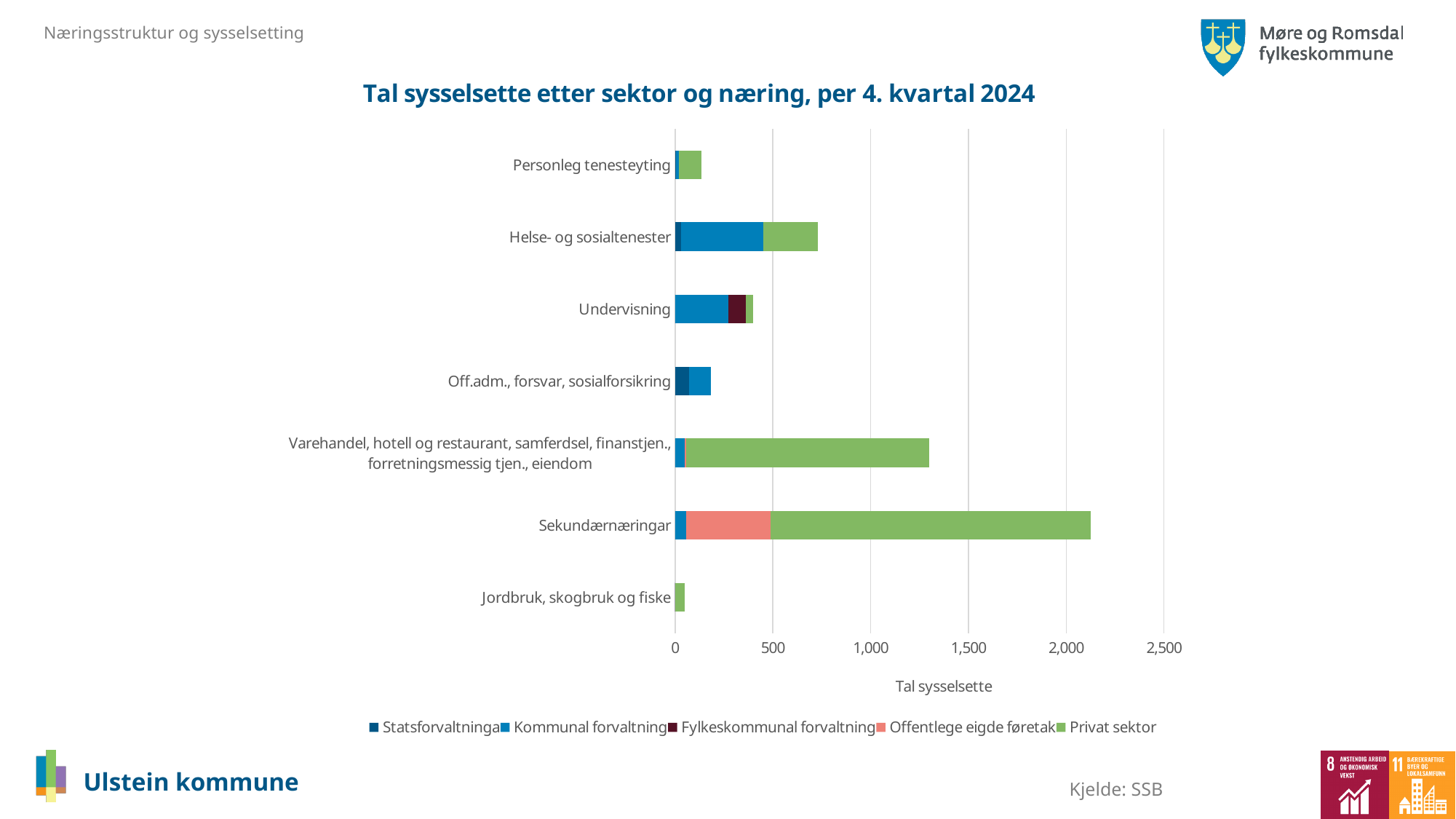
What is the title of the chart? Tal sysselsette etter sektor og næring, per 4. kvartal 2024 Which category has the shortest total bar? Jordbruk, skogbruk og fiske Which has the larger total bar: Helse- og sosialtenester or Undervisning? Helse- og sosialtenester Is the total value for Helse- og sosialtenester greater or less than 500? greater What kind of chart is shown on the slide? Stacked bar chart Is the total value for Undervisning greater or less than 500? less How many series does the legend list? 5 Is the total value for Varehandel, hotell og restaurant, samferdsel, finanstjen., forretningsmessig tjen., eiendom greater or less than 1,000? greater Which category has the longest total bar? Sekundærnæringar Which series is shown in green in the legend? Privat sektor How many categories (næringar) are shown on the y axis of the chart? 7